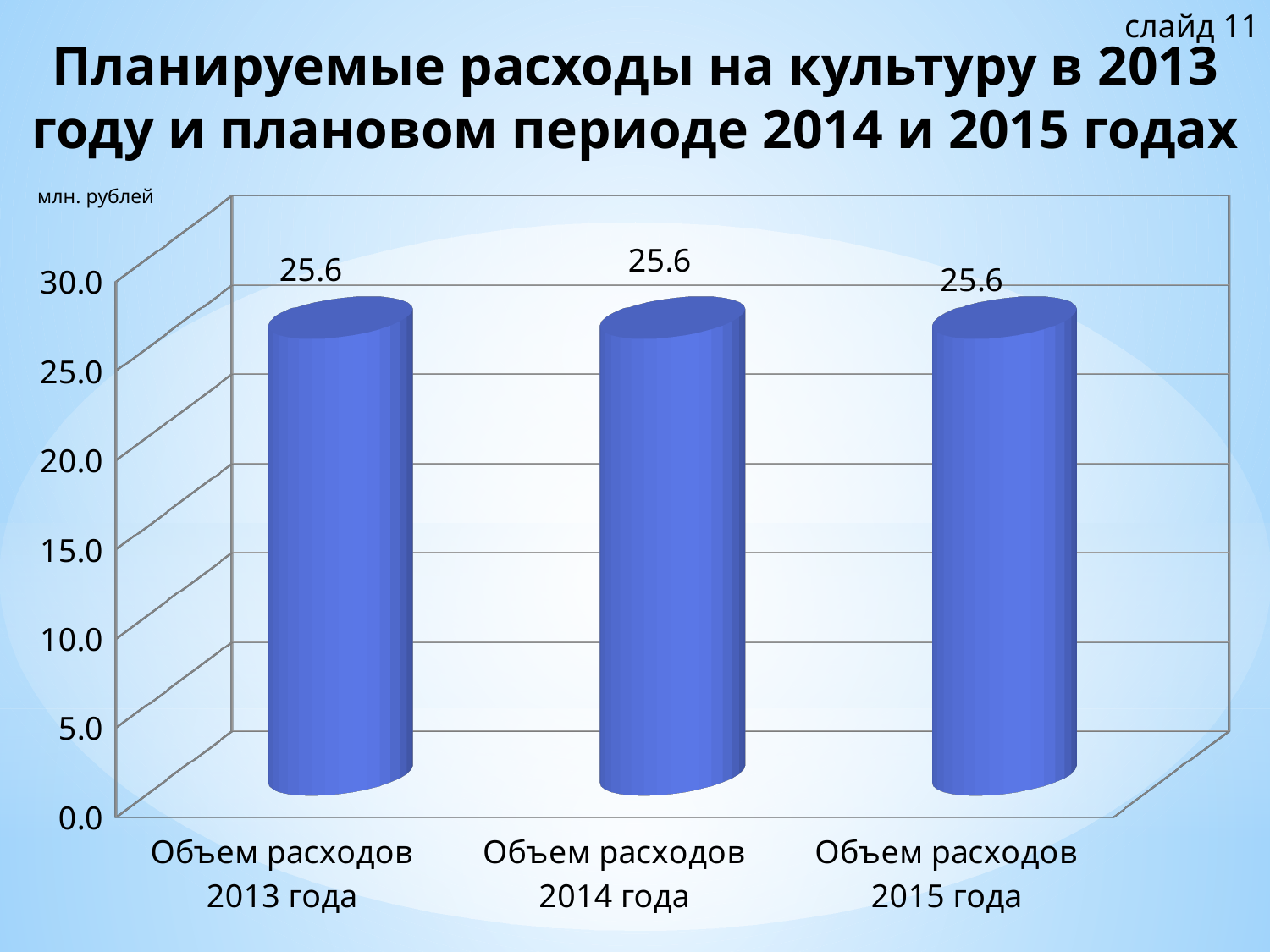
Is the value for Объем расходов 2013 года greater or less than 30.0? less What is the value for Объем расходов 2014 года? 25.6 What is the title of the slide containing the chart? Планируемые расходы на культуру в 2013 году и плановом периоде 2014 и 2015 годах What is the difference between the values for Объем расходов 2013 года and Объем расходов 2015 года? 0.0 Do the values rise, fall or stay the same from 2013 to 2015? Stay the same What unit is shown on the chart's value axis? млн. рублей What is the value for Объем расходов 2015 года? 25.6 What kind of chart is shown on the slide? Bar chart What is the value for Объем расходов 2013 года? 25.6 How many categories are shown on the chart? 3 Is the value for Объем расходов 2014 года greater or less than 20.0? greater